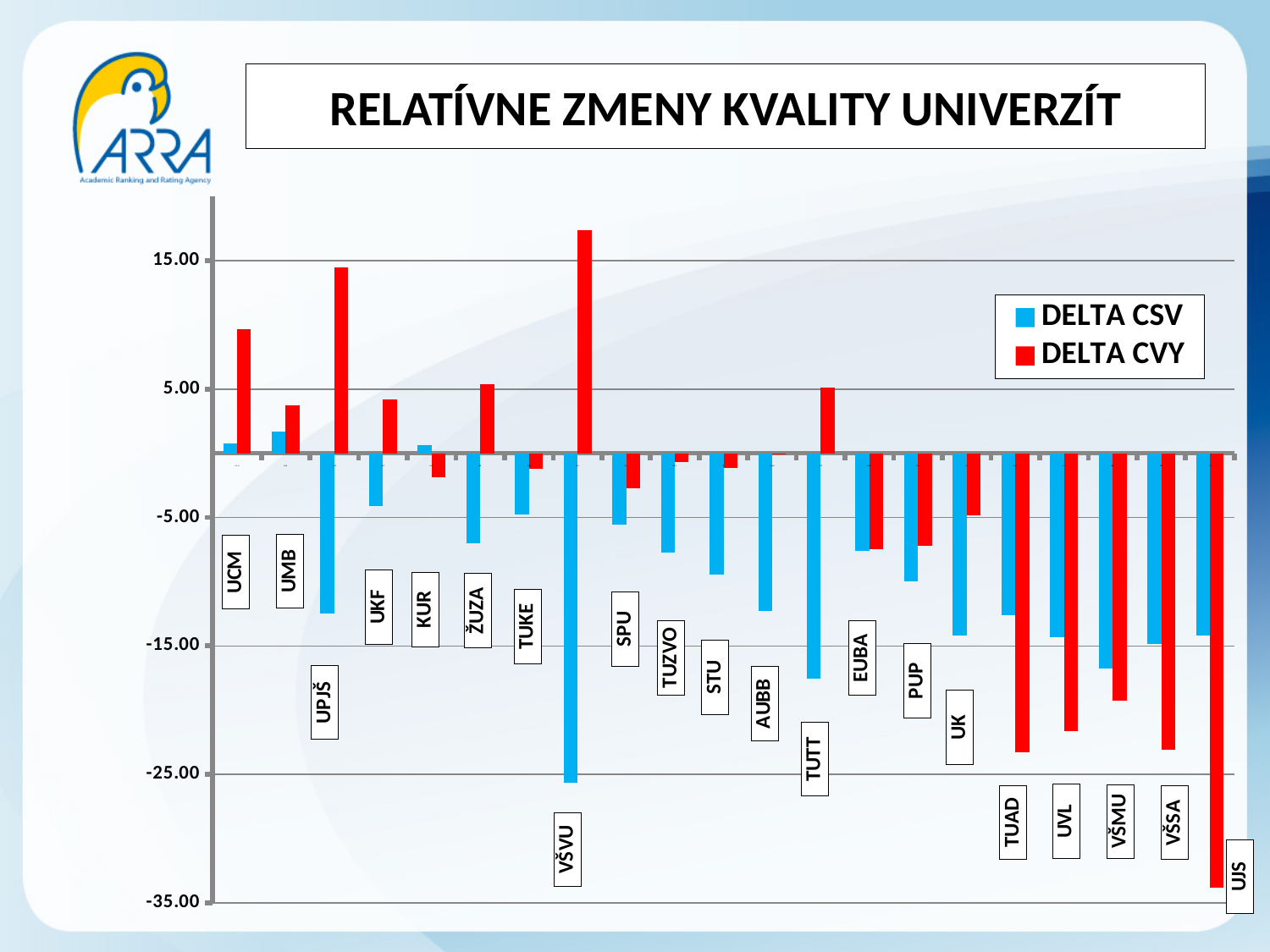
Which university has the lowest DELTA CSV value? VŠVU How many series does the legend list? 2 Is the DELTA CVY value for UJS greater or less than -25.00? less How many universities (categories) are shown on the x axis? 21 Which university has the lowest DELTA CVY value? UJS Do the DELTA CSV values generally rise or fall from left to right along the x axis? fall What kind of chart is shown on the slide? bar chart What is the title of the chart? RELATÍVNE ZMENY KVALITY UNIVERZÍT Which is larger, the DELTA CVY value for UPJŠ or for UCM? UPJŠ Which university has the highest DELTA CVY value? VŠVU Is the DELTA CSV value for UK greater or less than -5.00? less Is the DELTA CVY value for VŠVU greater or less than 15.00? greater